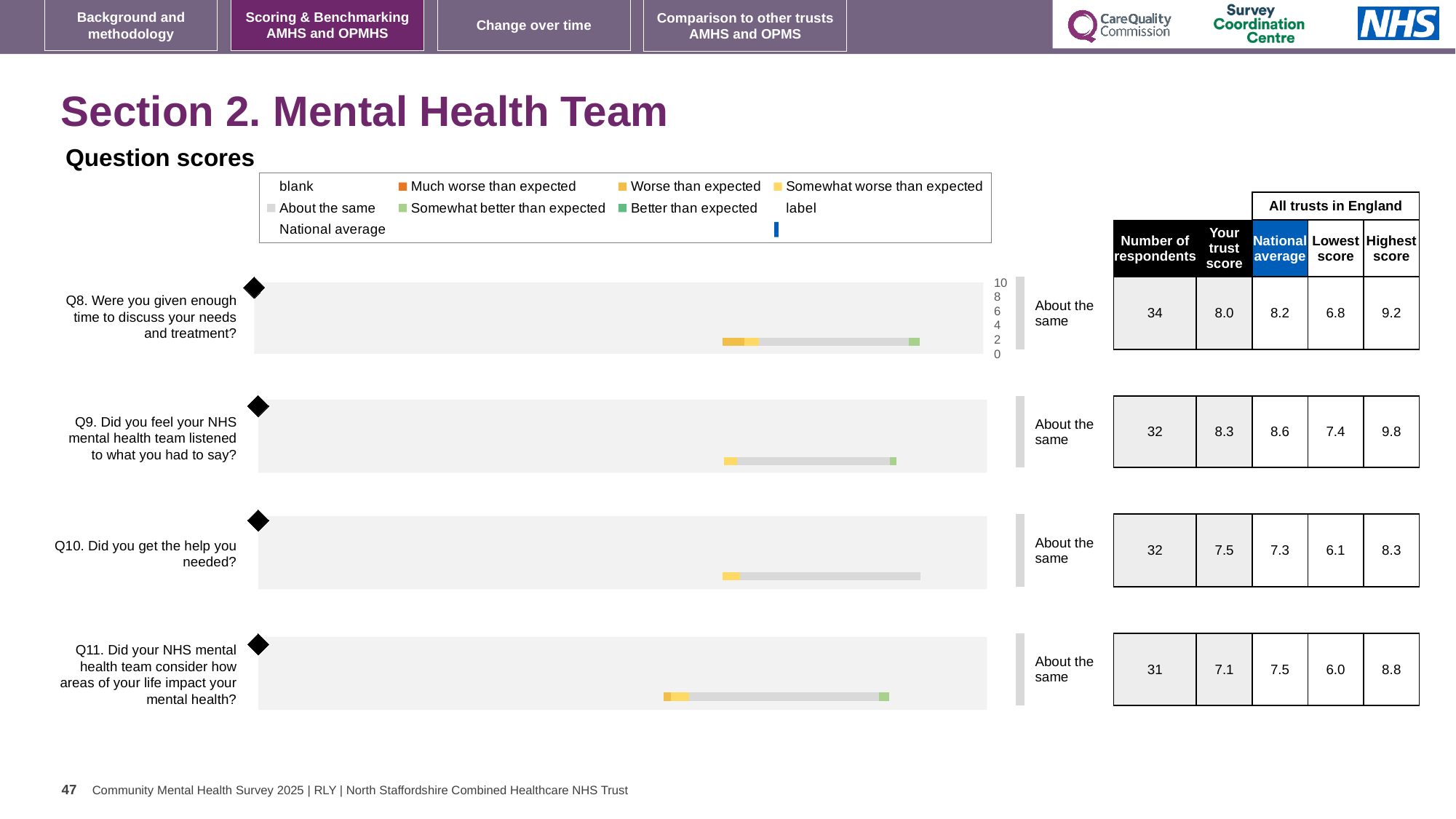
What is the highest score among all trusts in England for Q11? 8.8 What is the lowest score among all trusts in England for Q10? 6.1 What is the national average score for Q9 (Did you feel your NHS mental health team listened to what you had to say)? 8.6 What benchmark category is shown for Q11? About the same For Q8, what is the difference between the highest score and the lowest score among all trusts in England? 2.4 How many respondents answered Q10 (Did you get the help you needed)? 32 What kind of chart is used to show the question scores? Bar chart What is the trust score for Q8 (Were you given enough time to discuss your needs and treatment)? 8.0 For Q10, which is larger: the trust score or the national average? Trust score Which question has the highest trust score on this slide? Q9 Which question has the lowest trust score on this slide? Q11 How many questions are charted on this slide? 4